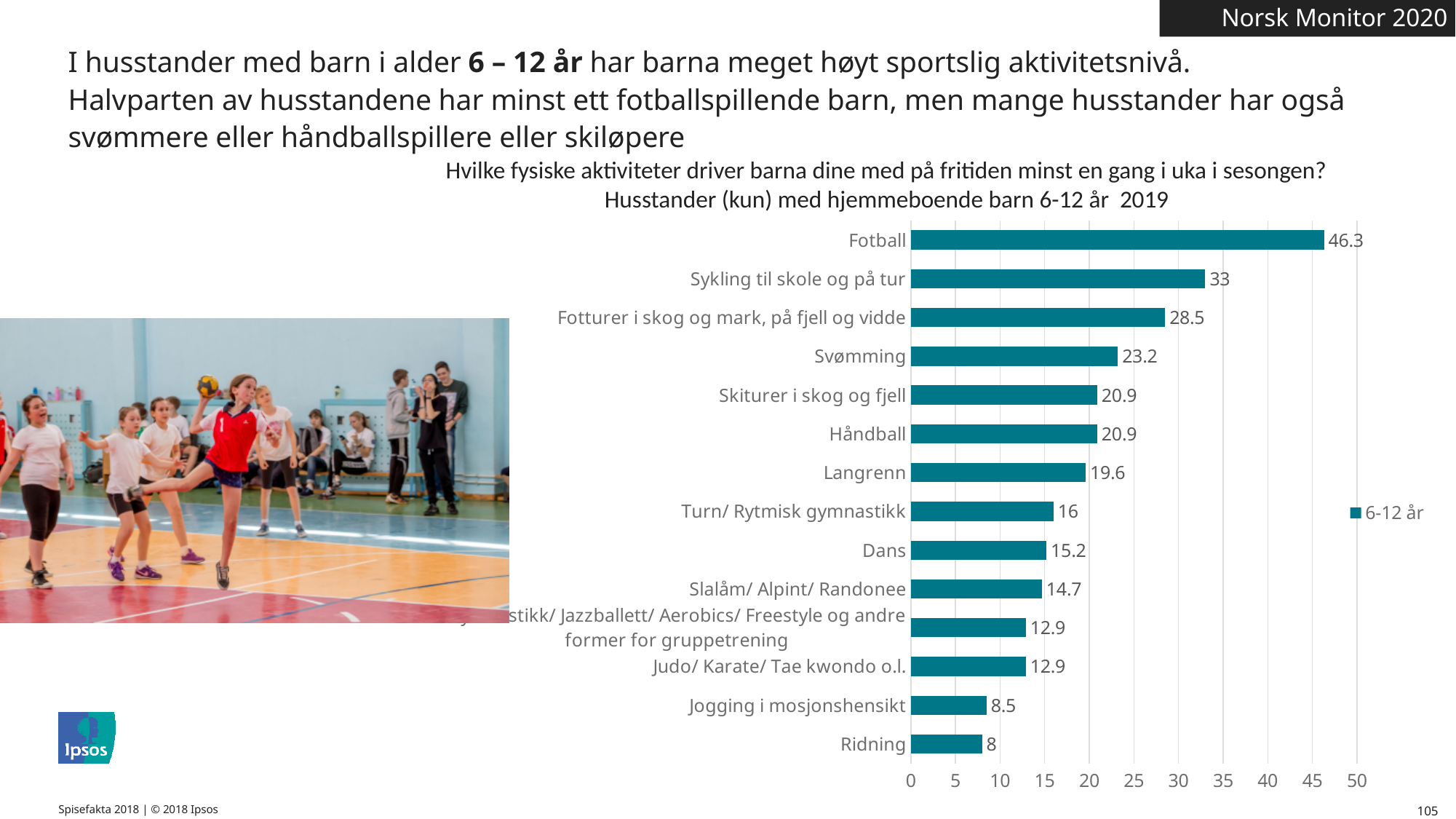
How many activities are shown in the chart? 14 What is the value for Håndball? 20.9 What is the value for Svømming? 23.2 What is the value for Jogging i mosjonshensikt? 8.5 What kind of chart is shown on the slide? Bar chart What is the value for Fotball? 46.3 How many series does the legend list? 1 Which activity has the highest value? Fotball What is the difference between the values for Fotball and Sykling til skole og på tur? 13.3 Which activity has the lowest value? Ridning Which has a larger value, Langrenn or Dans? Langrenn Is the value for Fotturer i skog og mark, på fjell og vidde greater or less than 25? greater